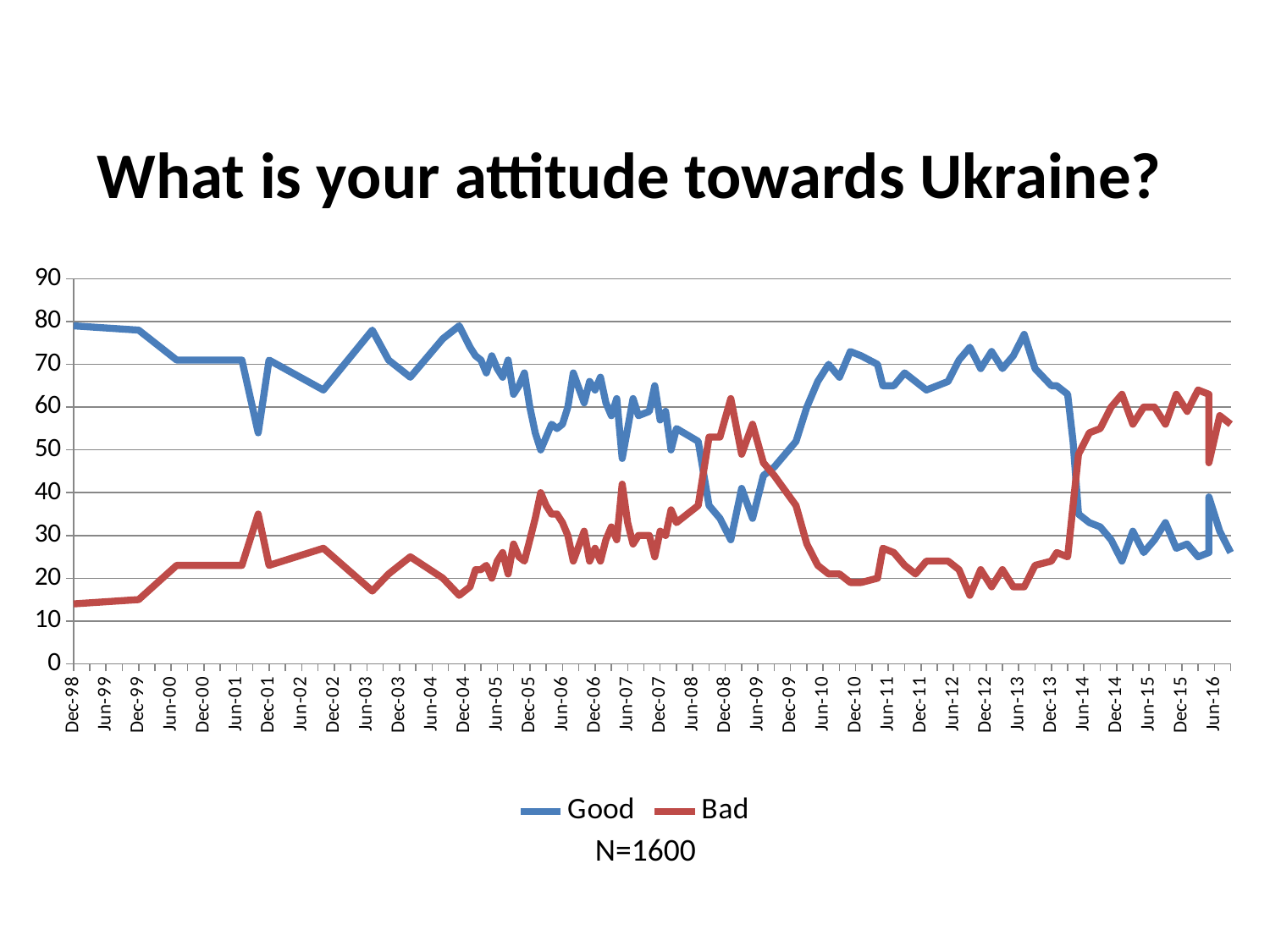
Is the value for Good at Dec-14 greater or less than 40? less What is the title of the chart? What is your attitude towards Ukraine? At Dec-14, which series has the larger value, Good or Bad? Bad How many series does the legend list? 2 Is the value for Good at Dec-98 greater or less than 70? greater Is the value for Bad at Dec-98 greater or less than 20? less Overall, does the Good series rise or fall from Dec-98 to Jun-16? fall What sample size is noted below the legend? N=1600 At Dec-98, which series has the larger value, Good or Bad? Good What kind of chart is shown on the slide? line chart